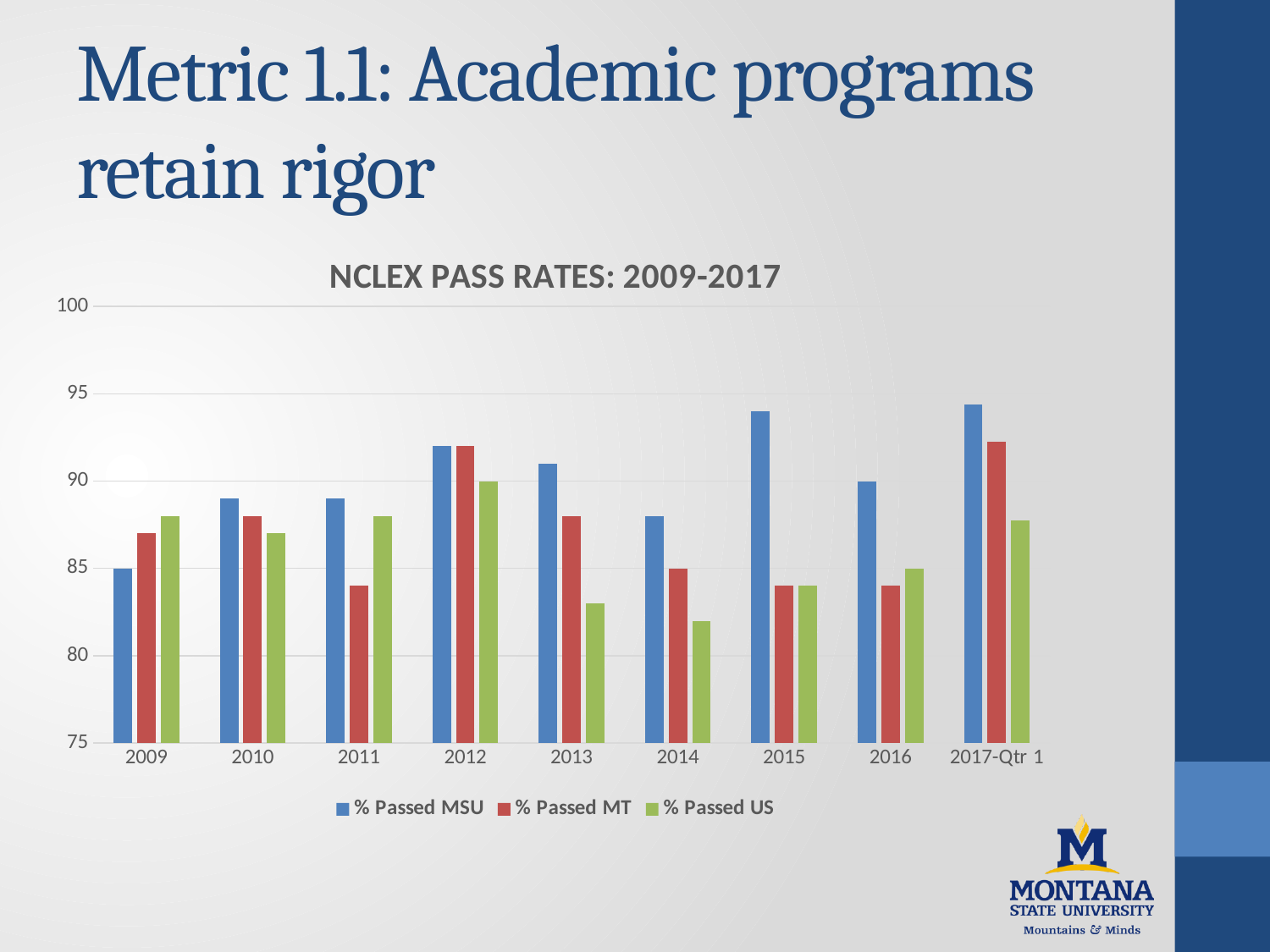
Which series is shown in green in the legend? % Passed US What is the title of the chart? NCLEX PASS RATES: 2009-2017 Is the % Passed MT value for 2011 greater or less than 85? less Is the % Passed MSU value for 2015 greater or less than 90? greater How many year categories are shown on the x axis? 9 Is the % Passed US value for 2014 greater or less than 85? less How many series does the legend list? 3 Which year has the lowest % Passed US value? 2014 In 2011, which is larger: % Passed MT or % Passed US? % Passed US What kind of chart is shown on the slide? bar chart In 2013, which is larger: % Passed MSU or % Passed MT? % Passed MSU Which year has the highest % Passed US value? 2012